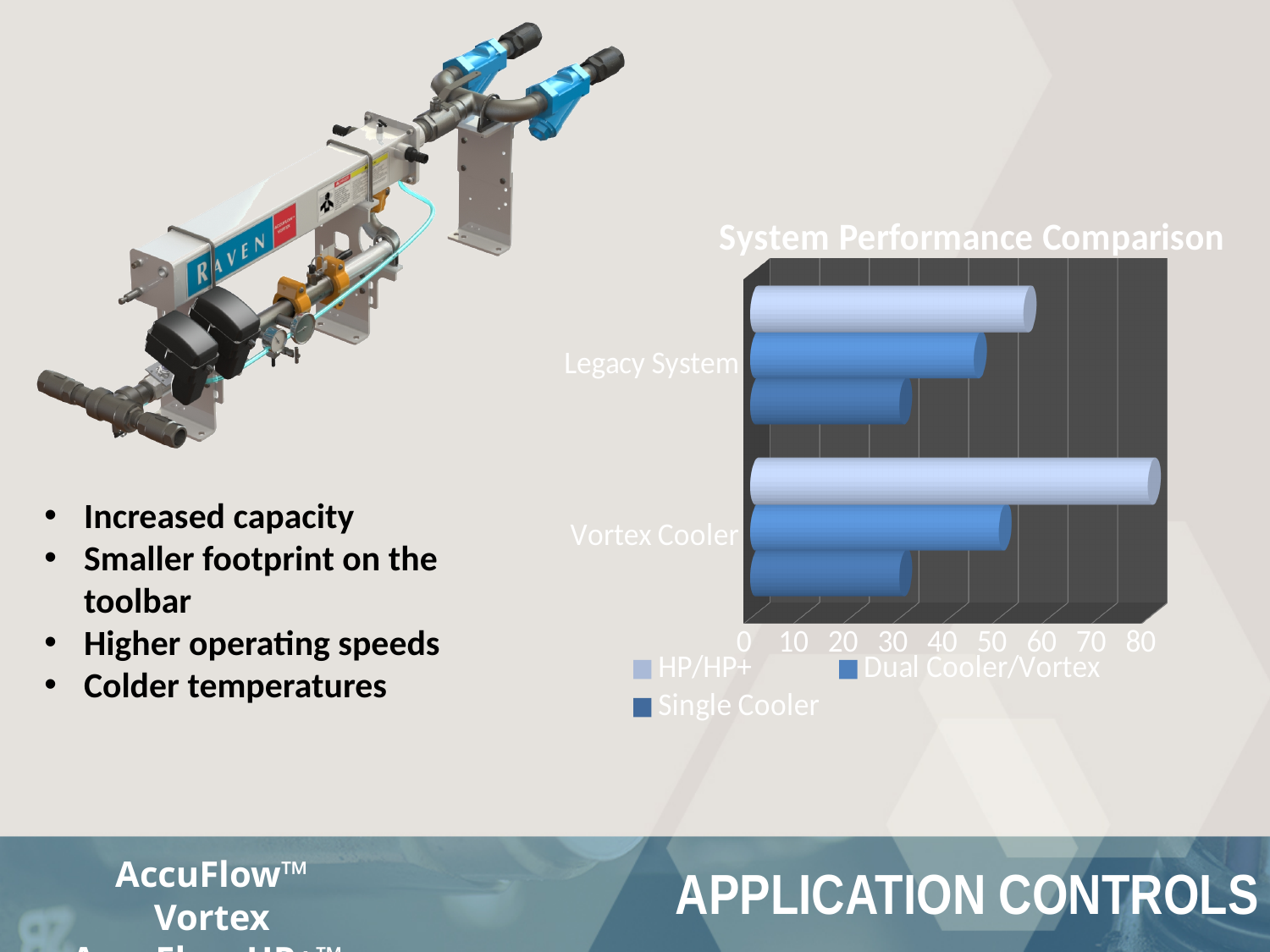
What type of chart is shown under the title "System Performance Comparison"? bar chart In the System Performance Comparison chart, is the Single Cooler value for Legacy System greater or less than 40? less What is the title of the chart on the slide? System Performance Comparison In the System Performance Comparison chart, is the HP/HP+ value for Vortex Cooler greater or less than 70? greater In the System Performance Comparison chart, is the HP/HP+ value for Legacy System greater or less than 50? greater Which series in the System Performance Comparison chart has the longest bar for Vortex Cooler? HP/HP+ Which series in the System Performance Comparison chart has the shortest bar for Legacy System? Single Cooler What is the highest value shown on the horizontal axis of the System Performance Comparison chart? 80 In the System Performance Comparison chart, which category has the larger HP/HP+ value, Legacy System or Vortex Cooler? Vortex Cooler How many series does the legend of the System Performance Comparison chart list? 3 How many categories are shown on the vertical axis of the System Performance Comparison chart? 2